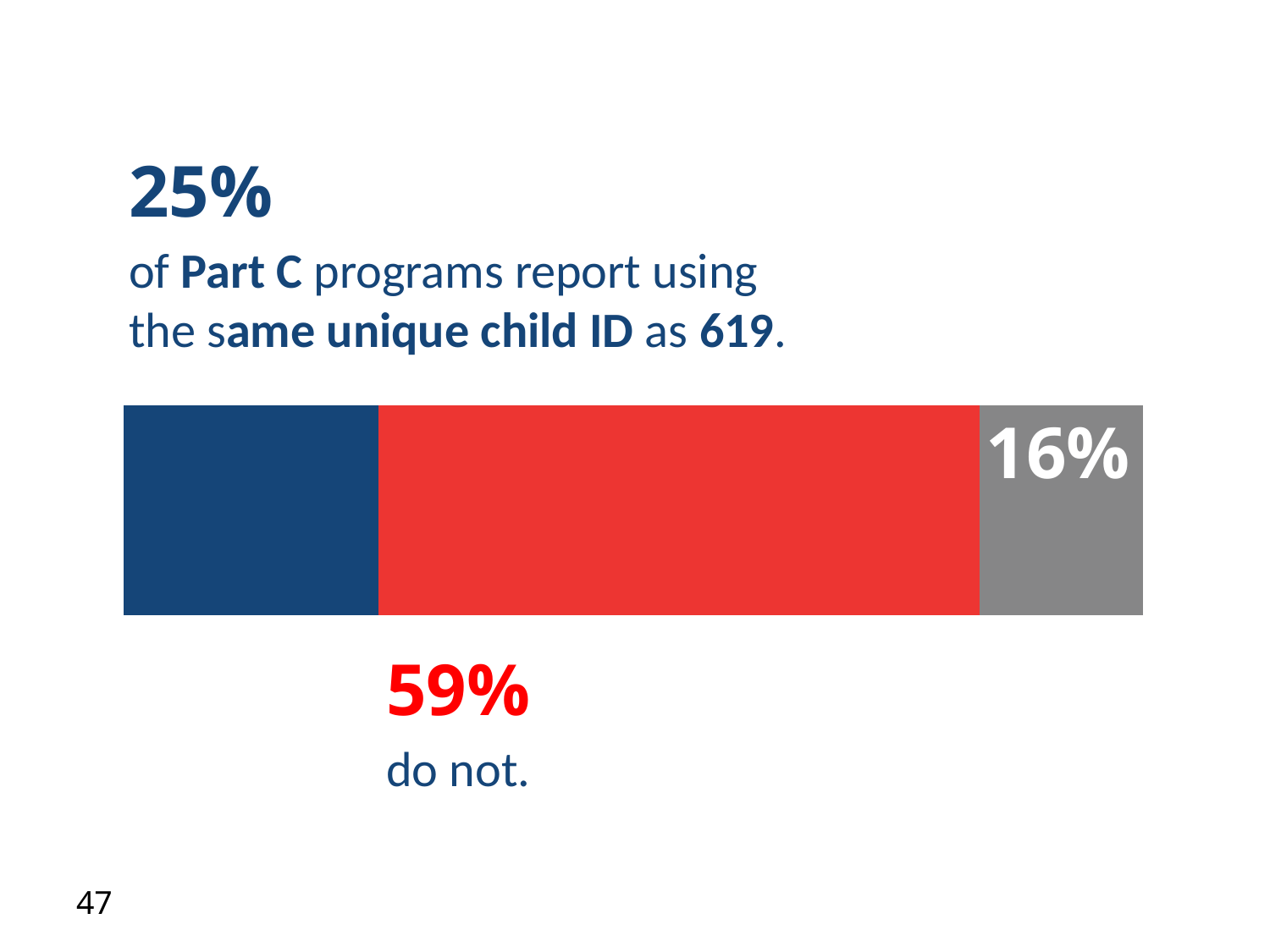
What percentage of Part C programs report using the same unique child ID as 619? 25% Is the value for the gray segment greater or less than 25%? less What do the three segments of the bar add up to? 100% Which is larger: the share of Part C programs using the same unique child ID as 619, or the share that do not? The share that do not (59%) Which segment of the bar is the largest? The red segment (59%, do not) What kind of chart is shown on the slide? A stacked bar chart What colour is the segment representing the 25% of Part C programs that use the same unique child ID as 619? Blue What value is printed on the gray segment of the bar? 16% What percentage of Part C programs do not use the same unique child ID as 619? 59% What is the difference in percentage points between the programs that do not use the same unique child ID (59%) and those that do (25%)? 34 percentage points How many segments make up the stacked bar? 3 Which segment of the bar is the smallest? The gray segment (16%)